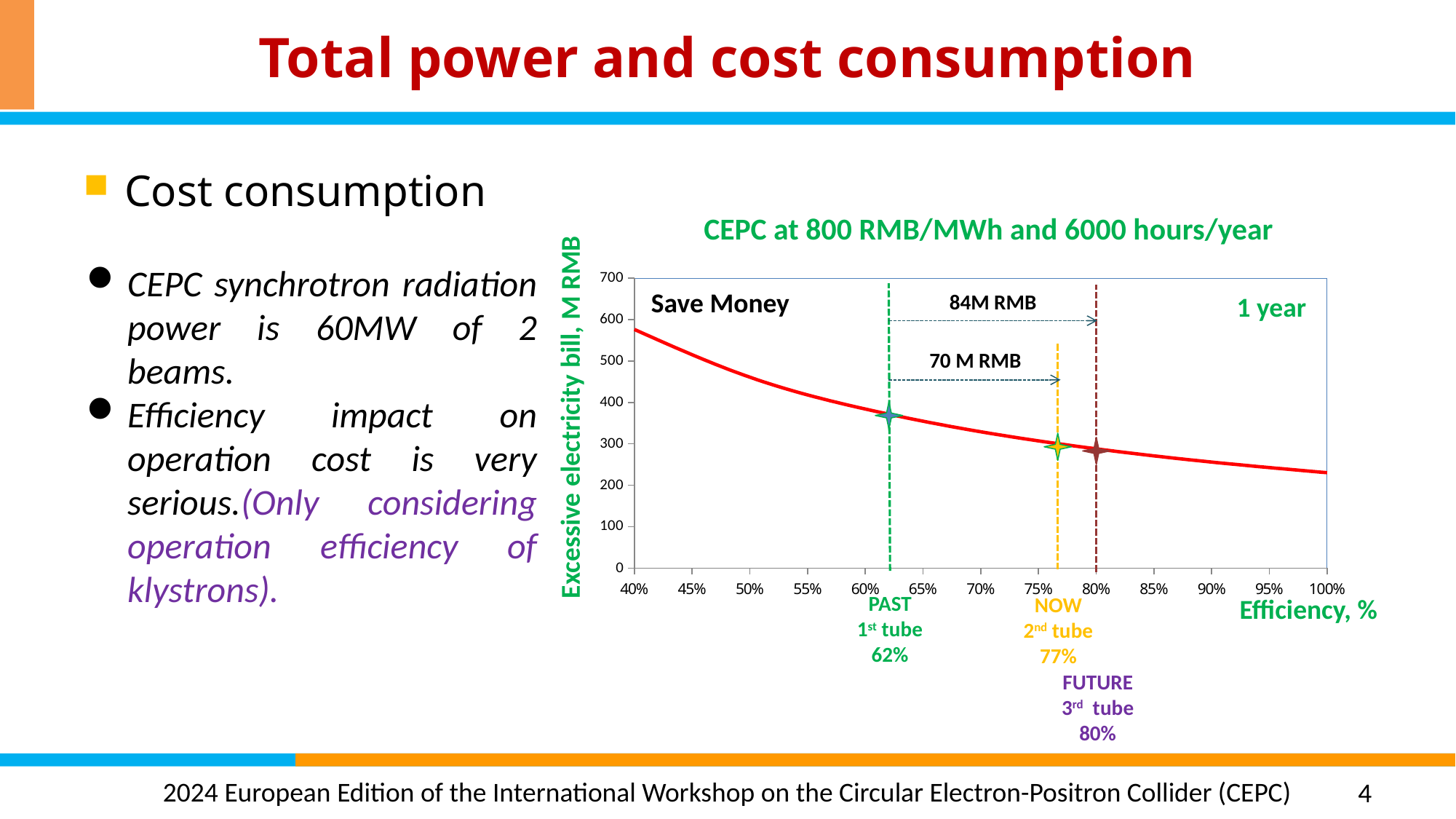
How many tube operating points (stars) are marked on the curve? 3 What is the title of the chart? CEPC at 800 RMB/MWh and 6000 hours/year Which has the higher excessive electricity bill, the PAST 1st tube or the FUTURE 3rd tube? PAST 1st tube According to the chart annotation, how much money is saved per year by moving from the 1st tube (62%) to the 3rd tube (80%)? 84M RMB What efficiency is marked for the FUTURE 3rd tube? 80% According to the chart annotation, how much money is saved per year by moving from the 1st tube (62%) to the 2nd tube (77%)? 70 M RMB Is the excessive electricity bill at 40% efficiency greater or less than 500 M RMB? greater Does the excessive electricity bill rise or fall as efficiency increases along the x axis? fall What efficiency is marked for the NOW 2nd tube? 77% Is the excessive electricity bill at the PAST 1st tube (62% efficiency) greater or less than 300 M RMB? greater What kind of chart is shown on the slide? line chart What efficiency is marked for the PAST 1st tube? 62%